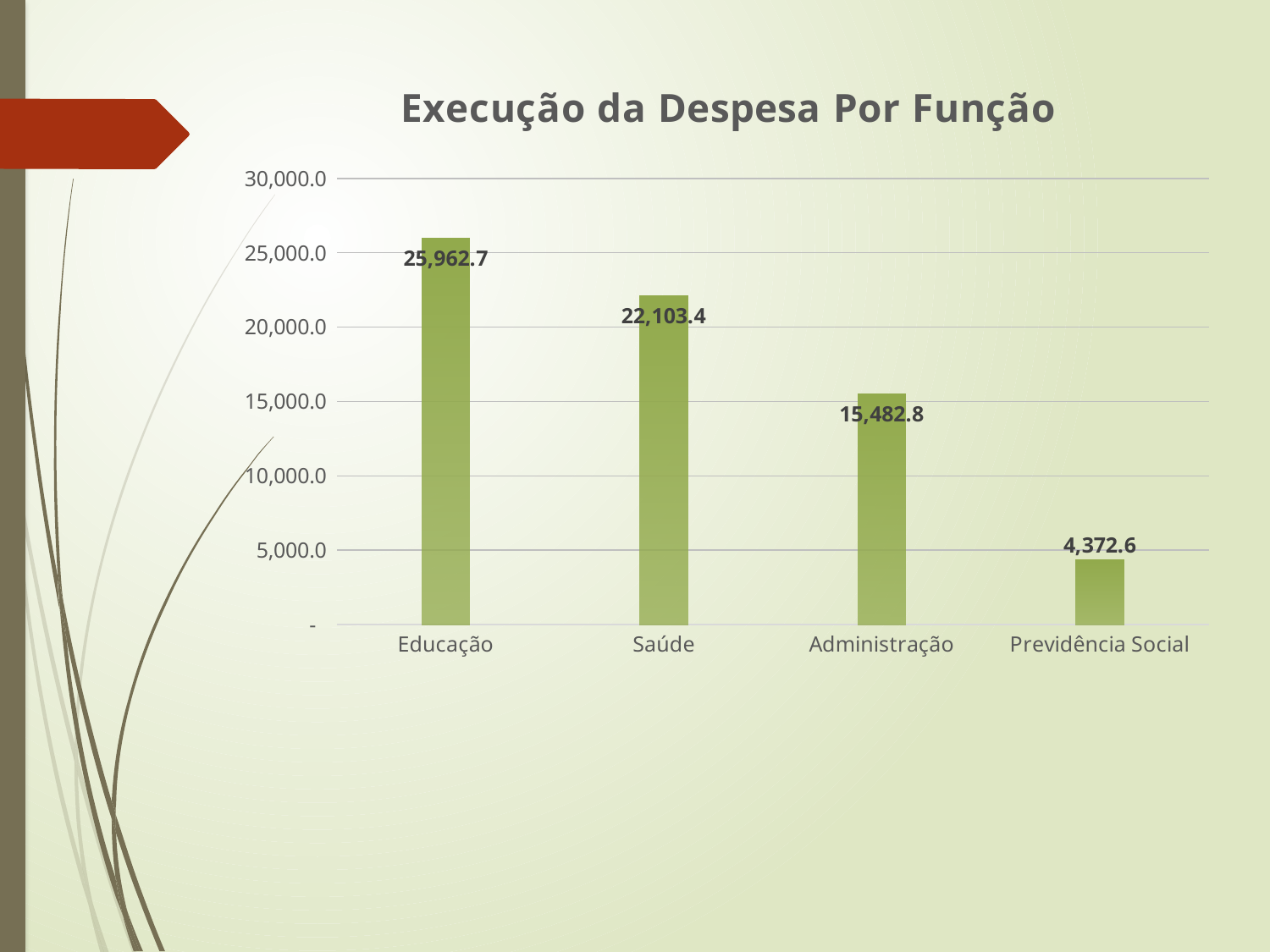
What is the value for Saúde? 22,103.4 What is the value for Educação? 25,962.7 Which category has the highest value? Educação What is the value for Previdência Social? 4,372.6 How many categories are shown in the chart? 4 Is the value for Previdência Social greater or less than 5,000.0? less What is the value for Administração? 15,482.8 Which category has the lowest value? Previdência Social What type of chart is shown on the slide? Bar chart What is the difference between the values for Administração and Previdência Social? 11,110.2 Which is larger, the value for Saúde or the value for Administração? Saúde What is the difference between the values for Educação and Saúde? 3,859.3